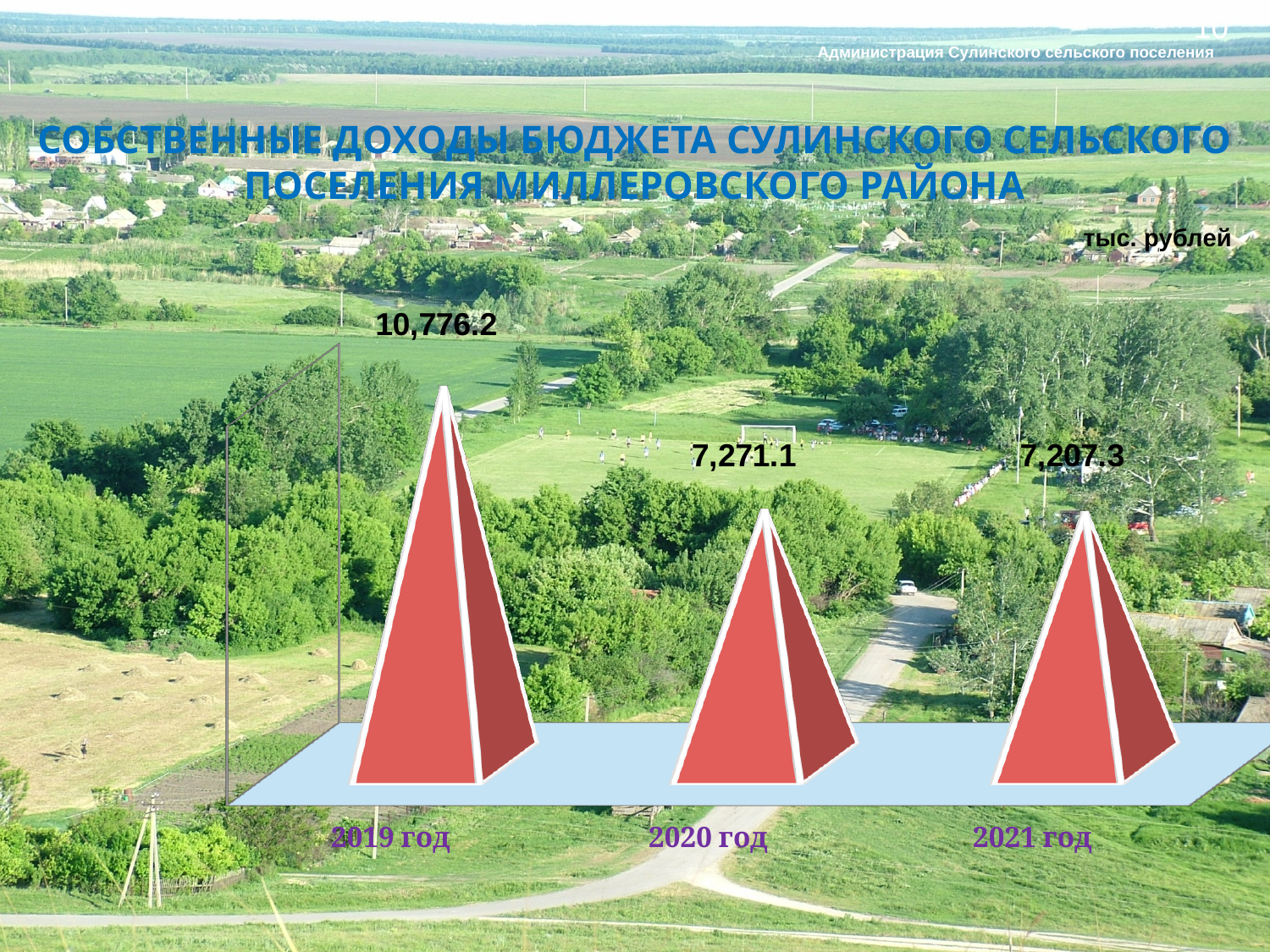
Which year has the lowest value? 2021 год What is the difference between the values for 2020 год and 2021 год? 63.8 Which year has the highest value? 2019 год In what units are the chart values given? тыс. рублей What is the difference between the values for 2019 год and 2020 год? 3,505.1 What is the value for 2021 год? 7,207.3 What is the value for 2019 год? 10,776.2 Do the values rise or fall from 2019 год to 2021 год? fall What is the value for 2020 год? 7,271.1 Which is larger, the value for 2020 год or the value for 2021 год? 2020 год How many years are shown in the chart? 3 What kind of chart is shown on the slide? bar chart